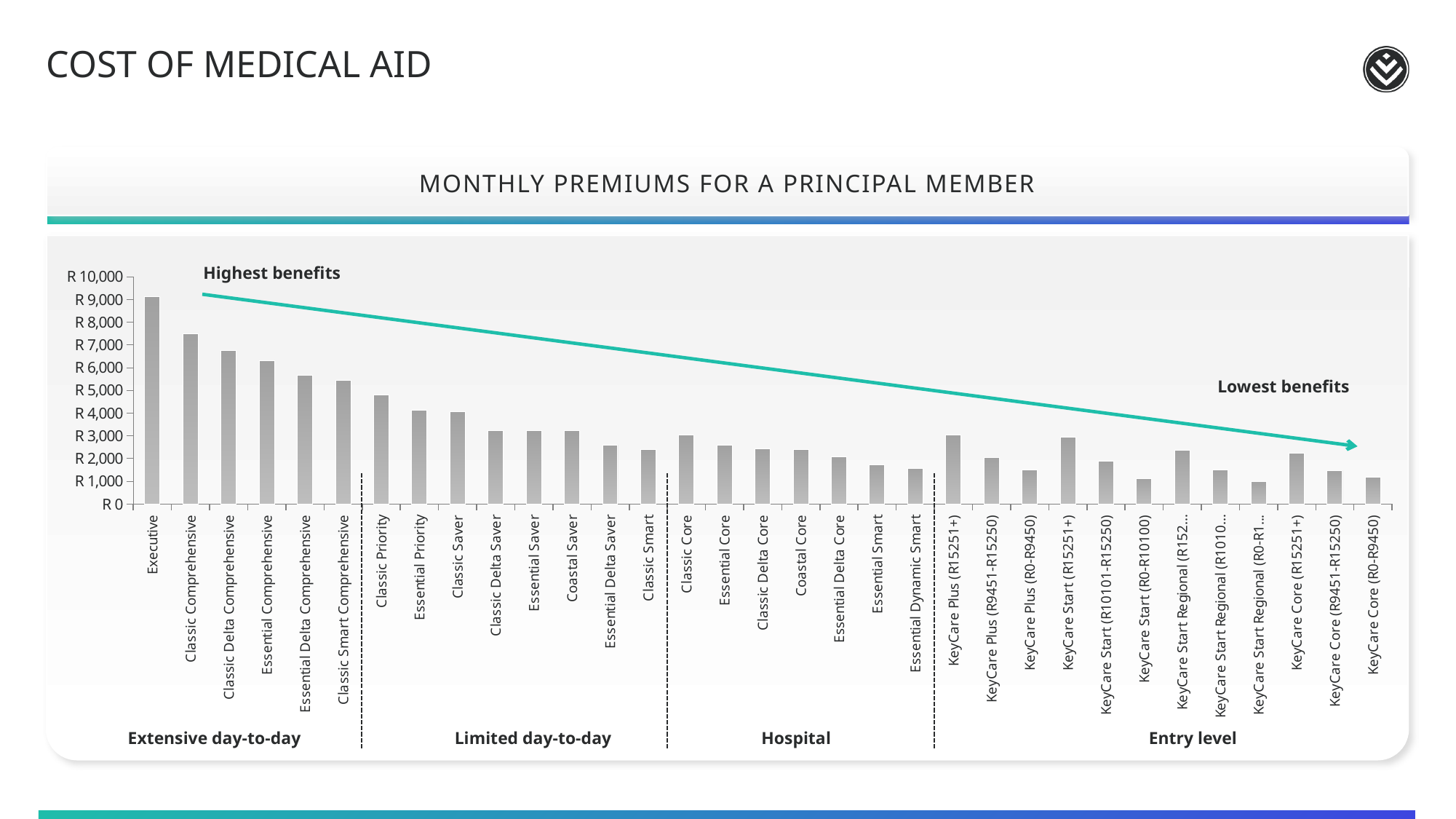
Is the monthly premium for Executive greater or less than R 8,000? greater What is the title of the chart? Monthly premiums for a principal member What kind of chart is shown on the slide? Bar chart Is the monthly premium for Classic Priority greater or less than R 5,000? less How many plans are in the Extensive day-to-day group? 6 Is the monthly premium for Essential Smart greater or less than R 2,000? less Which has the higher monthly premium, Classic Priority or Classic Core? Classic Priority Do the monthly premiums generally rise or fall from left to right across the chart? Fall How many plans (bars) are shown in the chart? 33 Which plan has the highest monthly premium? Executive Which has the higher monthly premium, KeyCare Start (R15251+) or KeyCare Core (R15251+)? KeyCare Start (R15251+) Which plan in the Hospital group has the lowest monthly premium? Essential Dynamic Smart